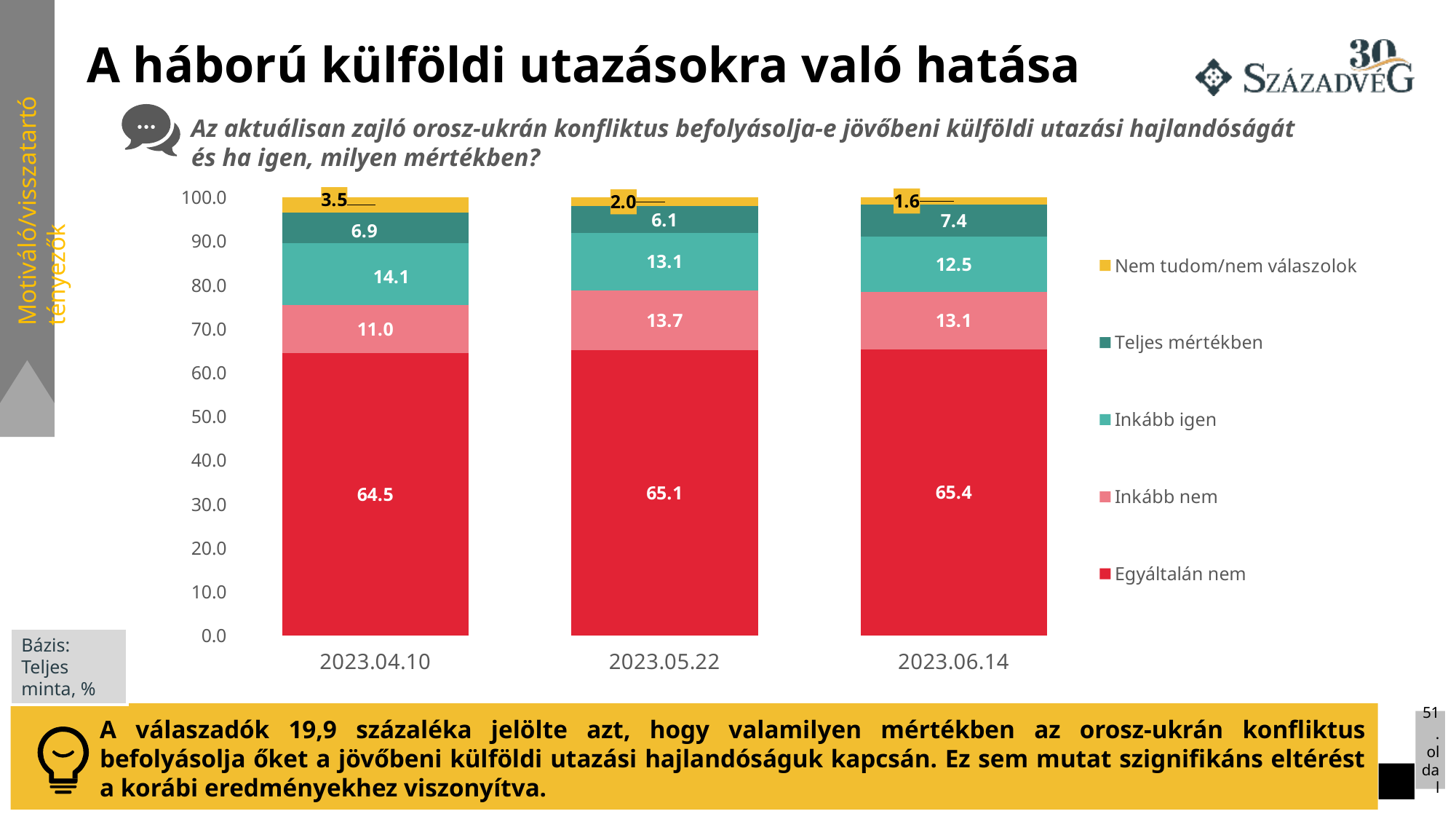
What is the total of the stacked bar for 2023.04.10? 100.0 Does the "Egyáltalán nem" value rise or fall from 2023.04.10 to 2023.06.14? Rises What is the value for "Egyáltalán nem" on 2023.05.22? 65.1 On which date is the "Inkább nem" value the lowest? 2023.04.10 What is the value for "Inkább igen" on 2023.04.10? 14.1 On which date is the "Teljes mértékben" value the highest? 2023.06.14 Which date has the larger "Inkább igen" value, 2023.05.22 or 2023.06.14? 2023.05.22 How many series does the legend list? 5 What is the value for "Nem tudom/nem válaszolok" on 2023.06.14? 1.6 What kind of chart is shown on the slide? Stacked bar chart How many dates are shown on the x axis of the chart? 3 How much higher is the "Inkább nem" value on 2023.05.22 than on 2023.04.10? 2.7